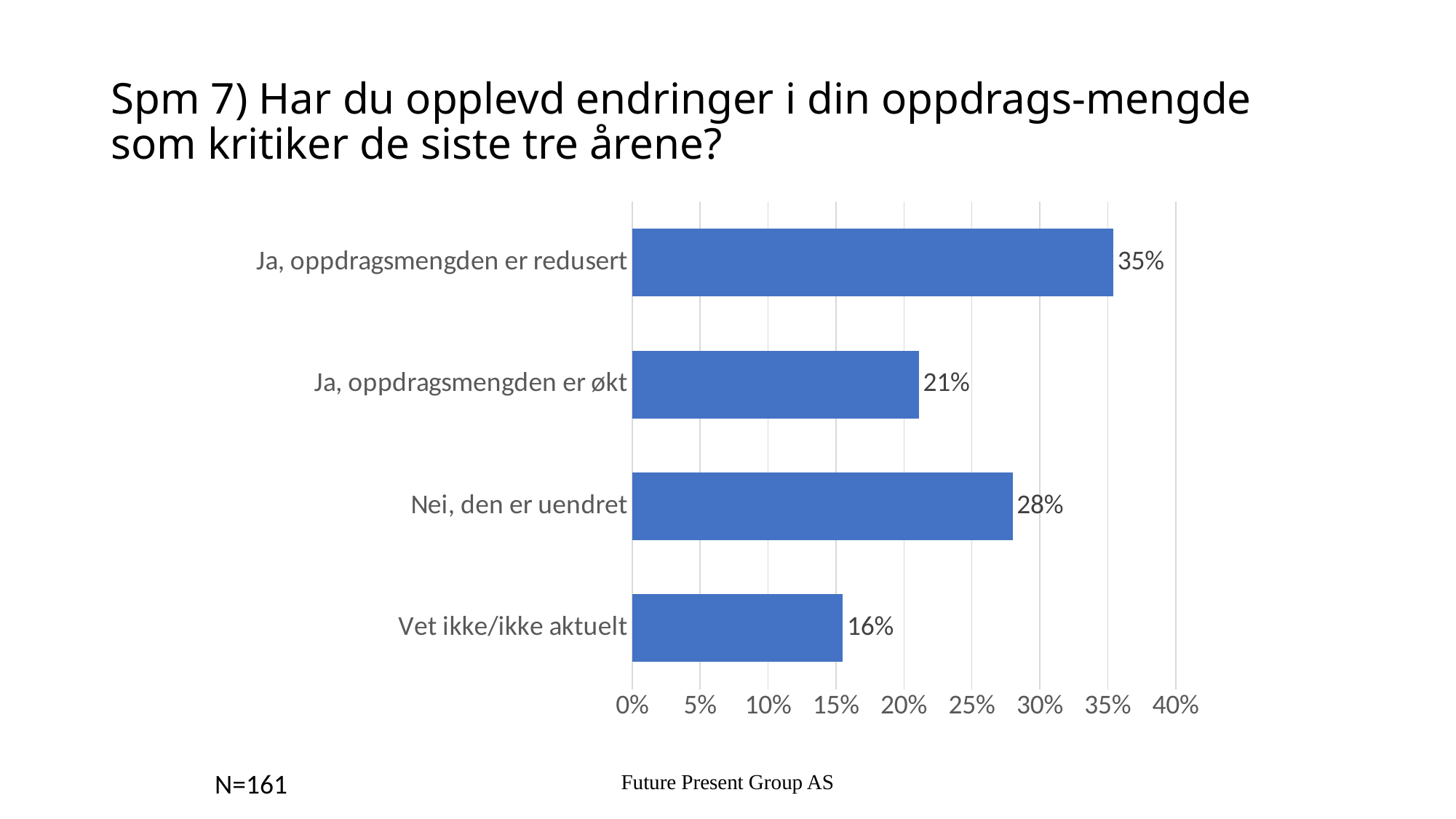
What is the value for "Nei, den er uendret"? 28% How many categories are shown in the chart? 4 Which category has the lowest value? Vet ikke/ikke aktuelt What is the difference between "Nei, den er uendret" and "Vet ikke/ikke aktuelt"? 12% What is the value for "Ja, oppdragsmengden er redusert"? 35% Which is larger, "Nei, den er uendret" or "Ja, oppdragsmengden er økt"? Nei, den er uendret What is the difference between "Ja, oppdragsmengden er redusert" and "Ja, oppdragsmengden er økt"? 14% What is the value for "Ja, oppdragsmengden er økt"? 21% What is the value for "Vet ikke/ikke aktuelt"? 16% Is the value for "Nei, den er uendret" greater or less than 25%? greater Which category has the highest value? Ja, oppdragsmengden er redusert What kind of chart is shown on the slide? Bar chart